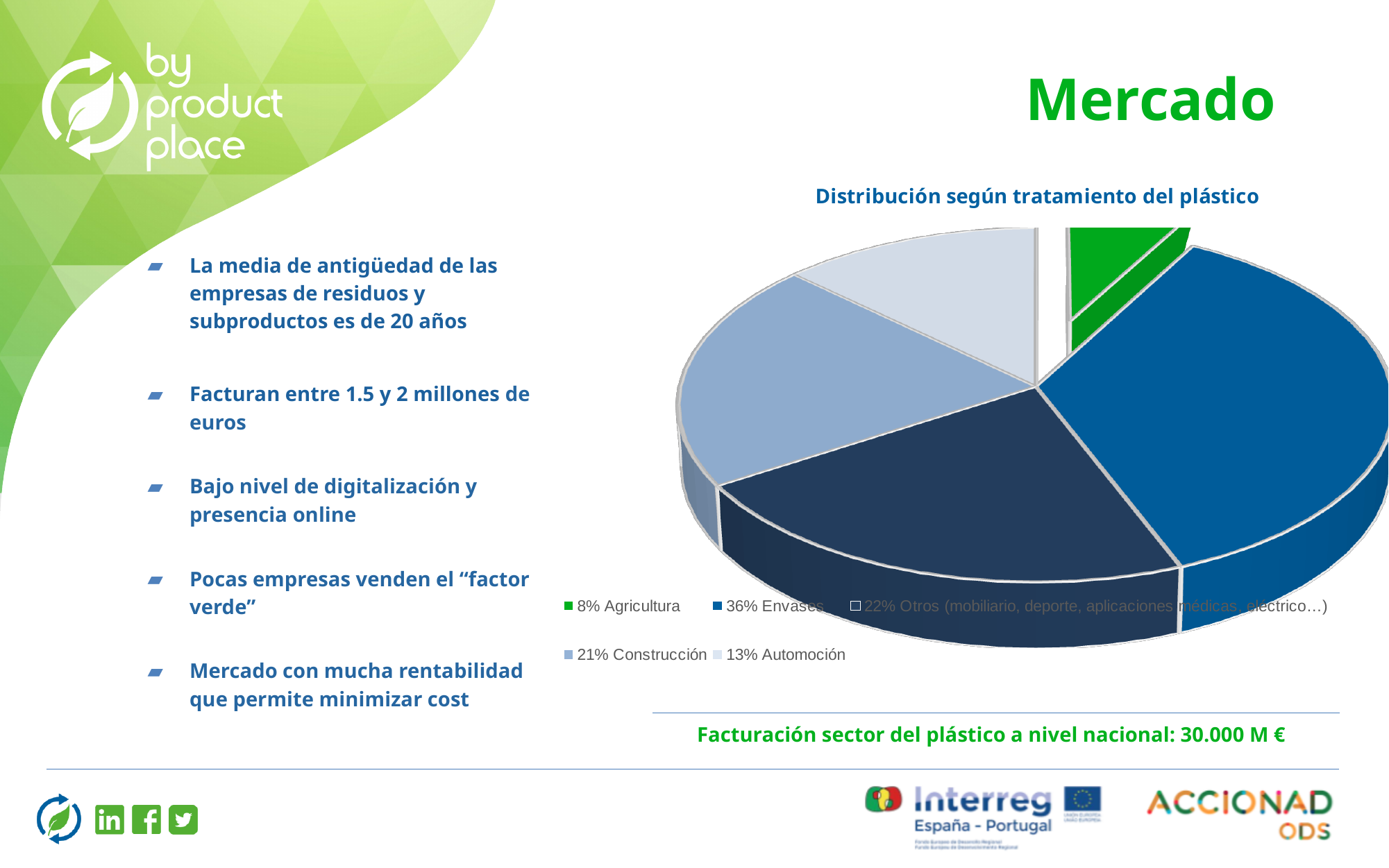
What share of the pie does Construcción represent? 21% How many categories does the pie chart show? 5 Which category has the largest slice of the pie? Envases Which category has the smallest slice of the pie? Agricultura Which is larger, the share for Otros or the share for Automoción? Otros What is the combined share of Agricultura and Automoción? 21% What share of the pie does Envases represent? 36% What kind of chart is shown under the title "Distribución según tratamiento del plástico"? Pie chart What colour is the Agricultura slice in the pie chart? Green What is the difference in percentage points between Envases and Construcción? 15 What share of the pie does Agricultura represent? 8% What share of the pie does Automoción represent? 13%